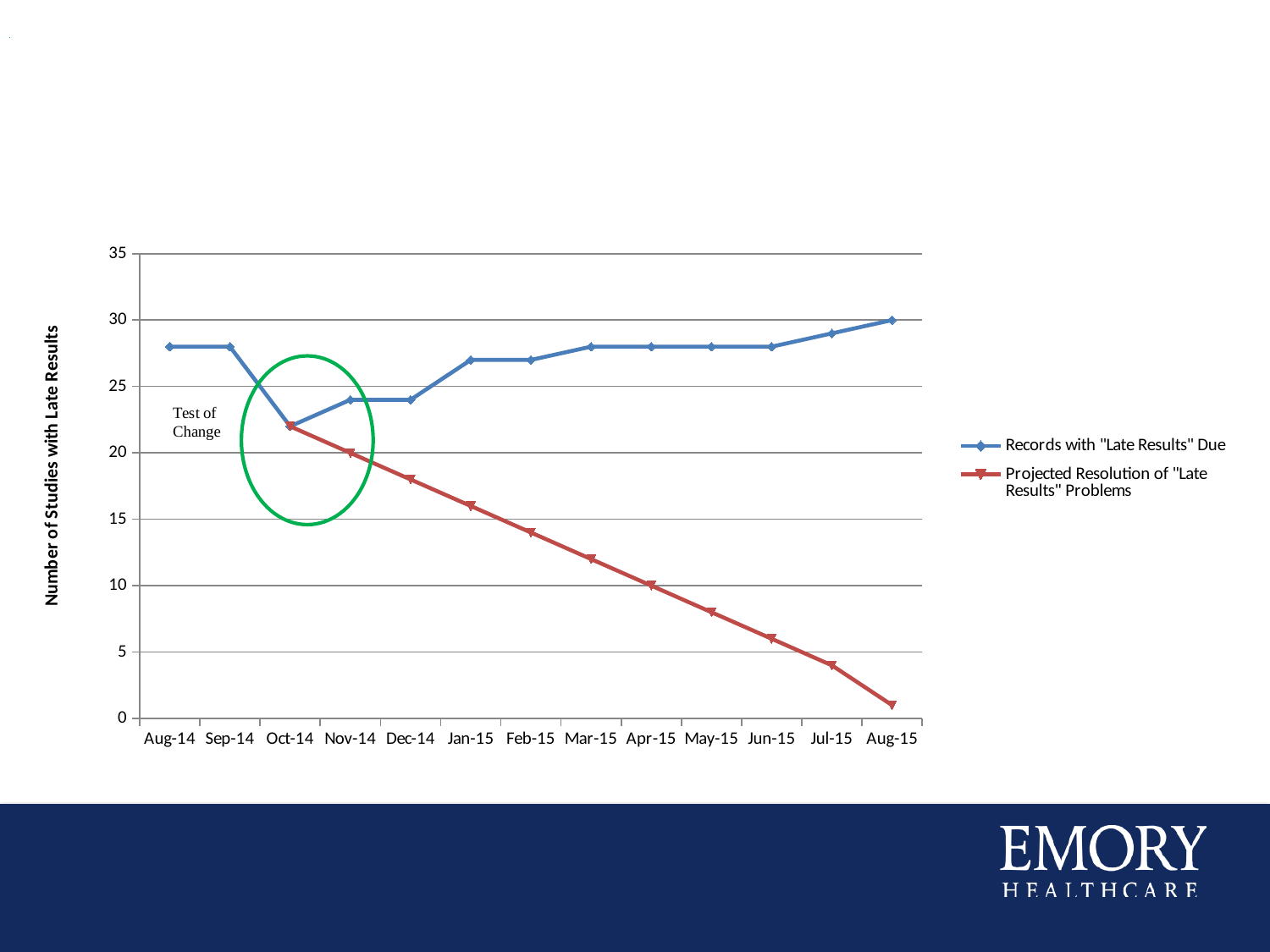
In which month is the Records with "Late Results" Due series at its lowest? Oct-14 What is the value for Records with "Late Results" Due in Aug-15? 30 What kind of chart is shown on the slide? line chart How many months are shown along the x axis? 13 What is the value for Projected Resolution of "Late Results" Problems in Nov-14? 20 Is the value for Records with "Late Results" Due in Aug-14 greater or less than 25? greater What is the title of the y axis? Number of Studies with Late Results In Jun-15, which series has the larger value: Records with "Late Results" Due or Projected Resolution of "Late Results" Problems? Records with "Late Results" Due What is the value for Projected Resolution of "Late Results" Problems in Apr-15? 10 Does the Projected Resolution of "Late Results" Problems series rise or fall from Oct-14 to Aug-15? fall In which month is the Records with "Late Results" Due series at its highest? Aug-15 How many series does the legend list? 2